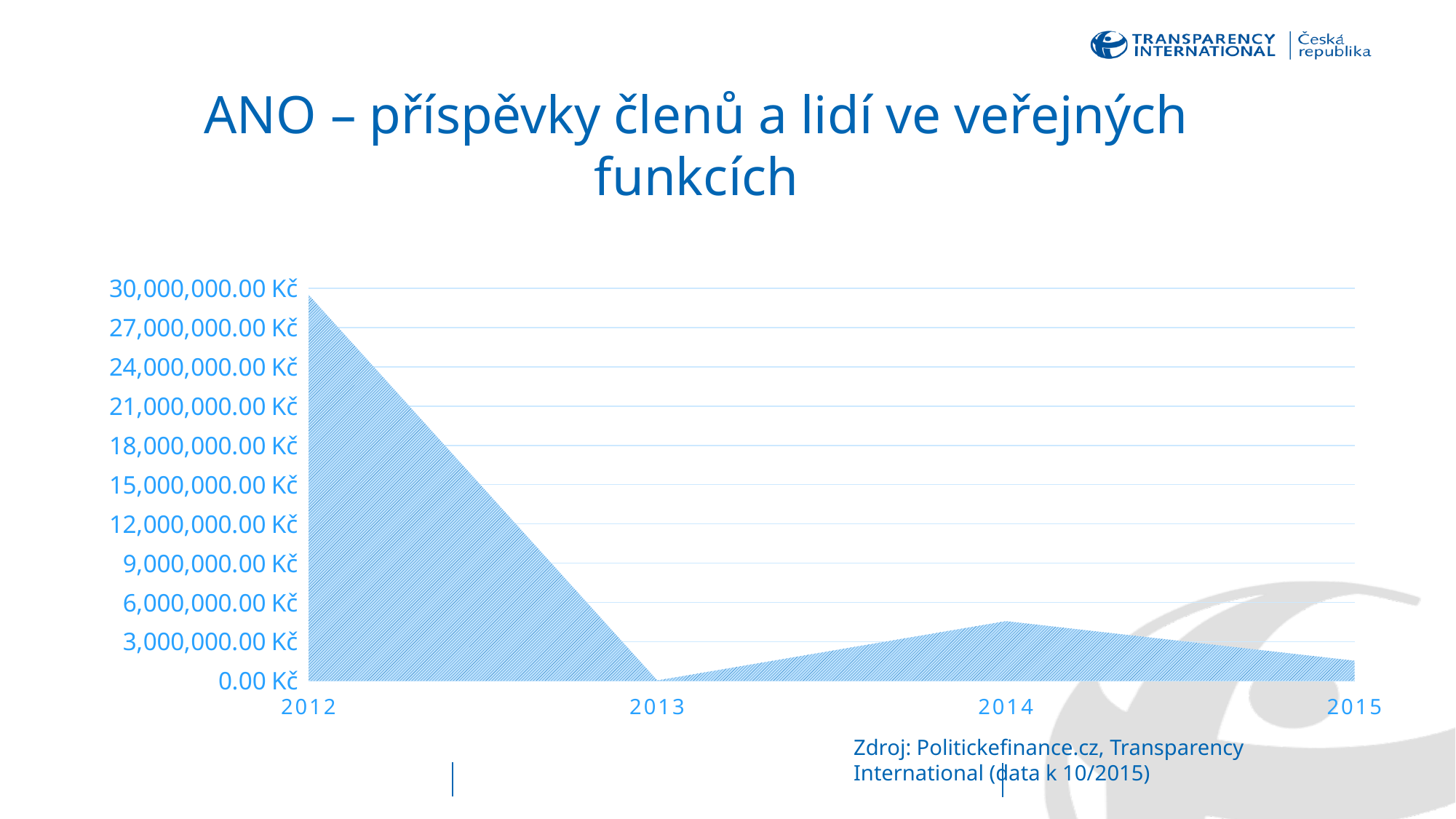
Which year has the lowest value? 2013 What kind of chart is shown on the slide? Area chart Do the values rise or fall from 2012 to 2013? fall What is the title of the chart on the slide? ANO – příspěvky členů a lidí ve veřejných funkcích What is the highest value shown on the y axis? 30,000,000.00 Kč Is the value for 2014 greater or less than 3,000,000.00 Kč? greater Is the value for 2015 greater or less than 3,000,000.00 Kč? less Is the value for 2012 greater or less than 27,000,000.00 Kč? greater How many years are plotted along the x axis? 4 Which year has the highest value? 2012 Which is larger, the value for 2014 or the value for 2015? 2014 Which is larger, the value for 2012 or the value for 2014? 2012